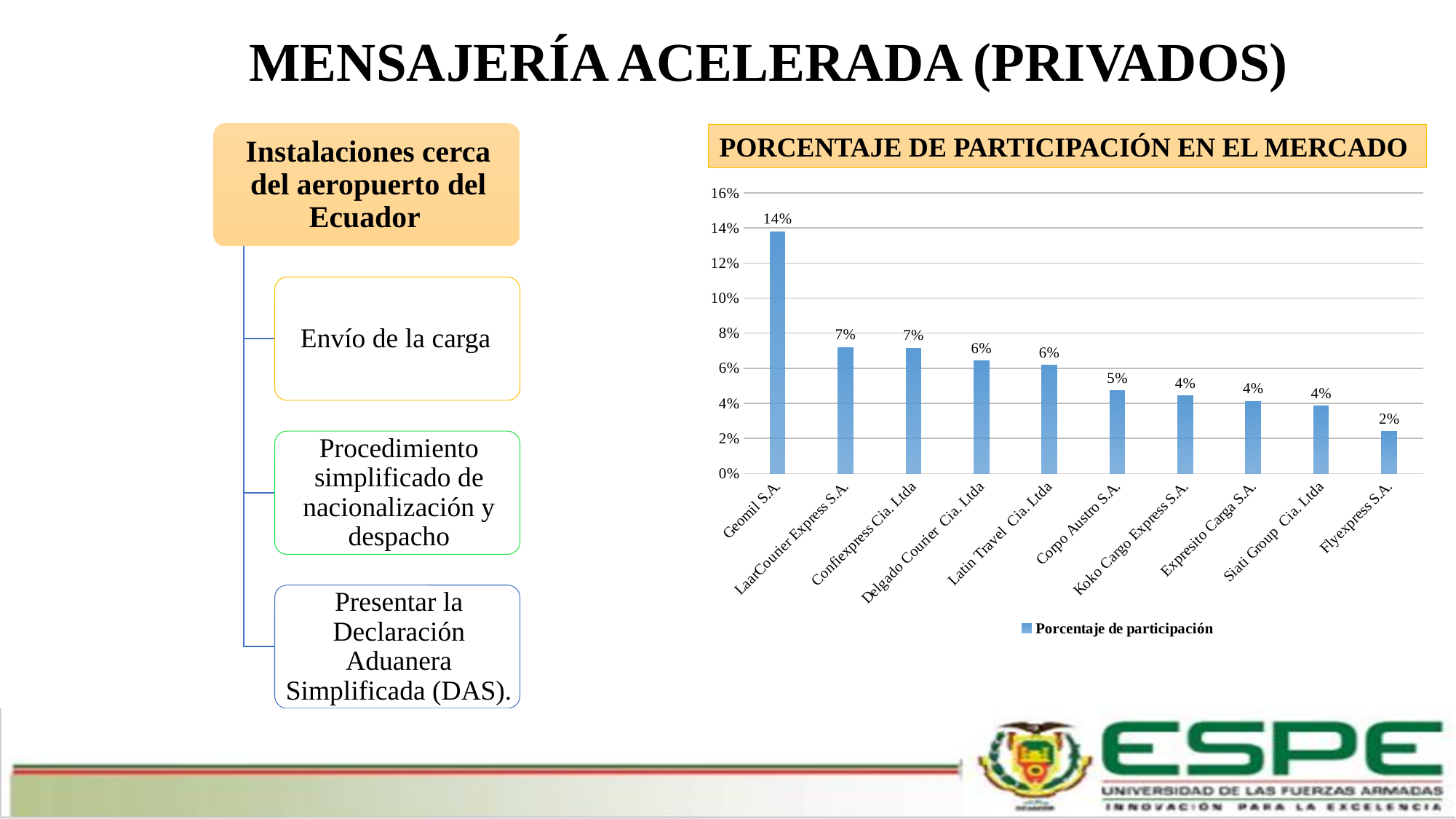
What is the value shown for Delgado Courier Cia. Ltda? 6% Do the values rise or fall from left to right along the x axis? Fall Which has a larger market share, Geomil S.A. or LaarCourier Express S.A.? Geomil S.A. Which company has the lowest percentage of market participation? Flyexpress S.A. What is the difference between the values for Geomil S.A. and Flyexpress S.A.? 12% What is the value shown for Corpo Austro S.A.? 5% How many companies are shown on the chart? 10 What kind of chart is shown on the slide? Bar chart Is the value for Geomil S.A. greater or less than 10%? greater Which company has the highest percentage of market participation? Geomil S.A. What is the value shown for Flyexpress S.A.? 2% What is the market share shown for Geomil S.A.? 14%